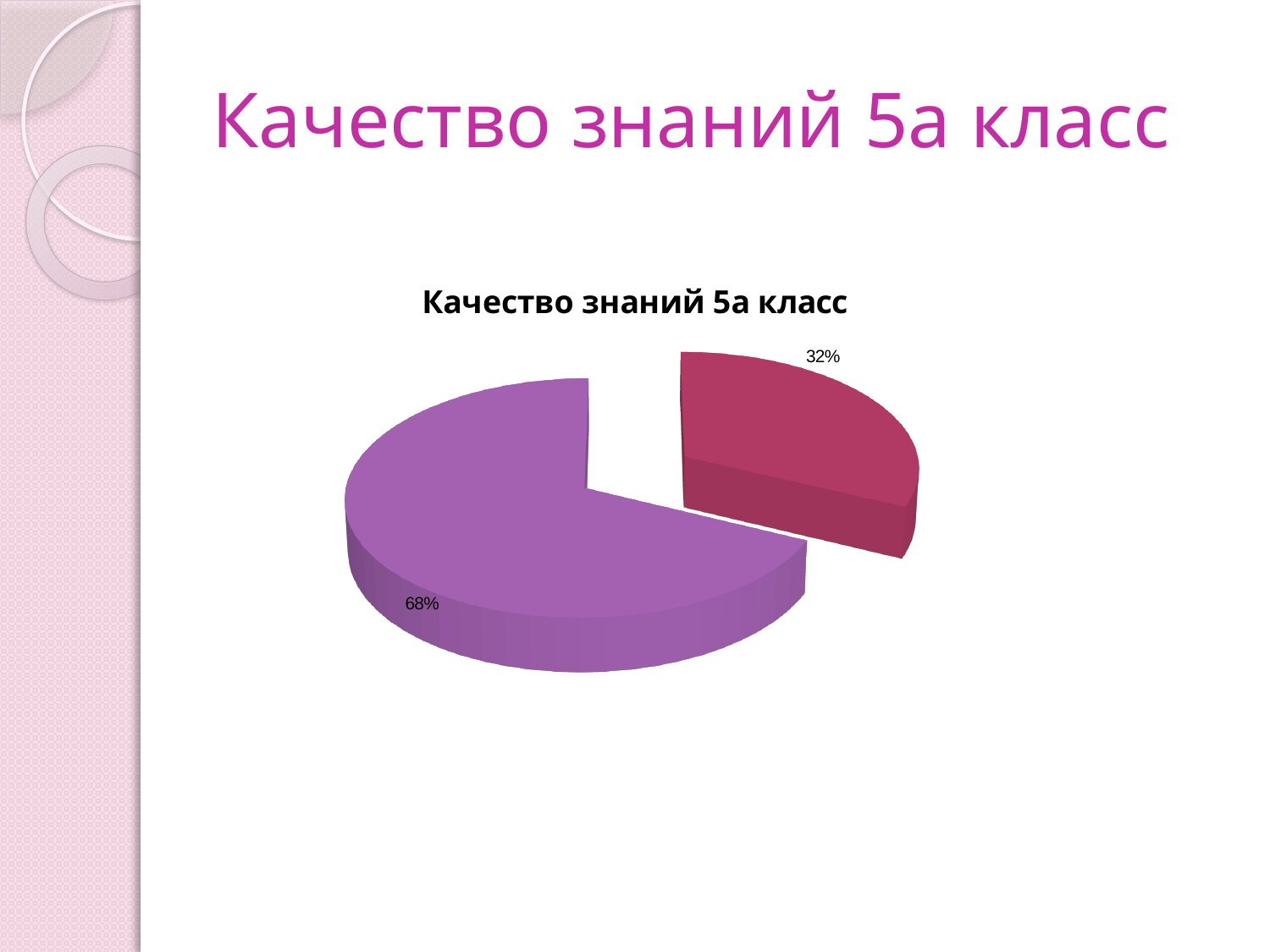
What is the difference in percentage points between the purple slice and the red slice? 36 Which slice of the pie chart is the smallest? the red slice (32%) What percentage is shown on the red slice of the pie chart? 32% What kind of chart is shown on the slide? pie chart Which is larger, the purple slice or the red slice? the purple slice How many slices does the pie chart have? 2 Which slice of the pie chart is the largest? the purple slice (68%) What is the title of the chart? Качество знаний 5а класс Is the value of the purple slice greater or less than 50%? greater What share of the pie does the red slice represent? 32% What percentage is shown on the purple slice of the pie chart? 68% Which slice is pulled out (exploded) from the rest of the pie? the red slice (32%)